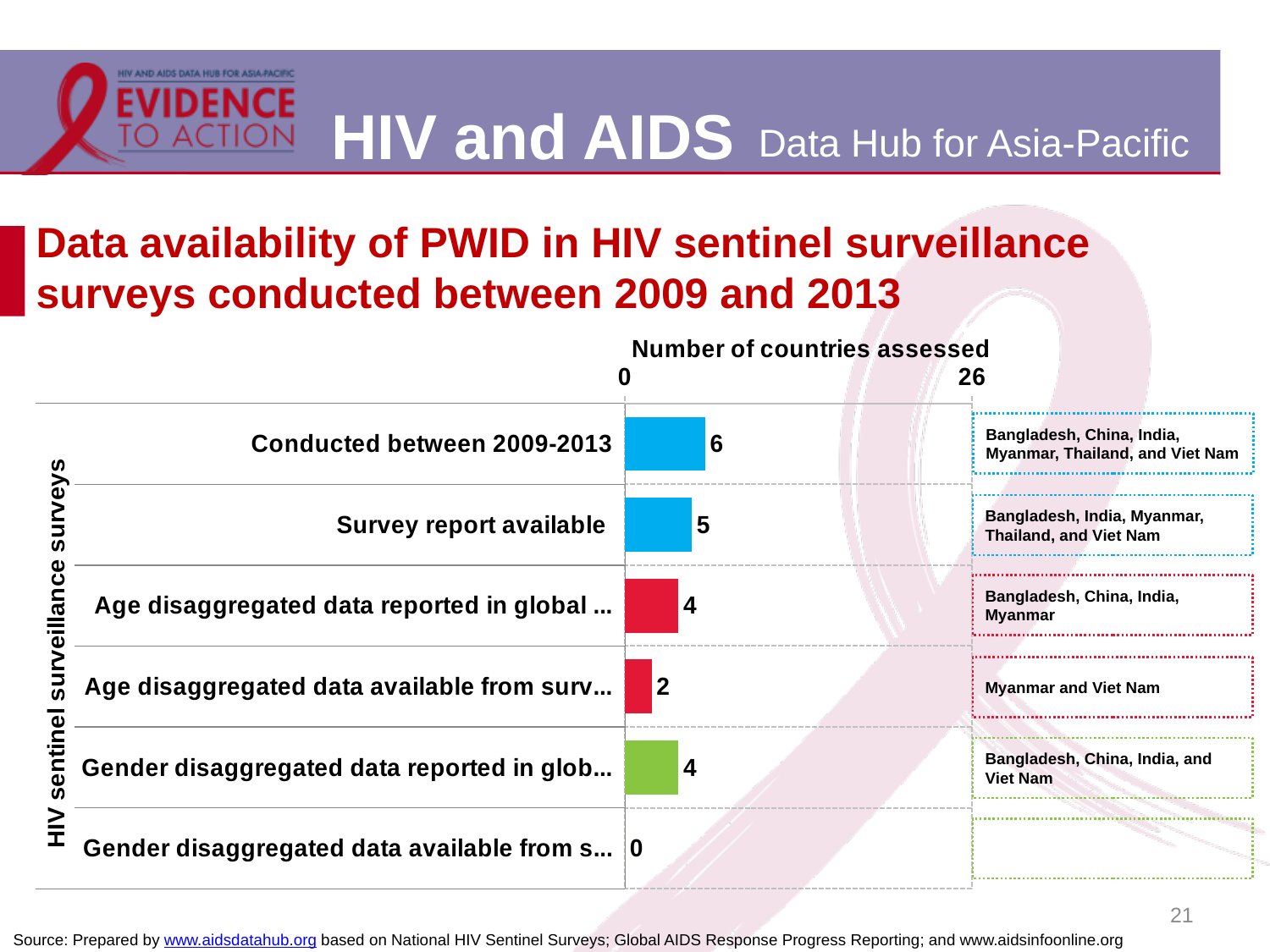
What is the value for "Gender disaggregated data available from s..."? 0 Which category has the highest value? Conducted between 2009-2013 How many categories are shown in the chart? 6 What is the value for "Survey report available"? 5 What is the title of the chart's value axis? Number of countries assessed What is the difference between the values for "Conducted between 2009-2013" and "Survey report available"? 1 Which is larger, the value for "Age disaggregated data reported in global ..." or the value for "Age disaggregated data available from surv..."? Age disaggregated data reported in global ... What is the value for "Conducted between 2009-2013"? 6 Which category has the lowest value? Gender disaggregated data available from s... What is the maximum value shown on the chart's value axis? 26 What is the value for "Age disaggregated data available from surv..."? 2 What kind of chart is shown on the slide? Bar chart